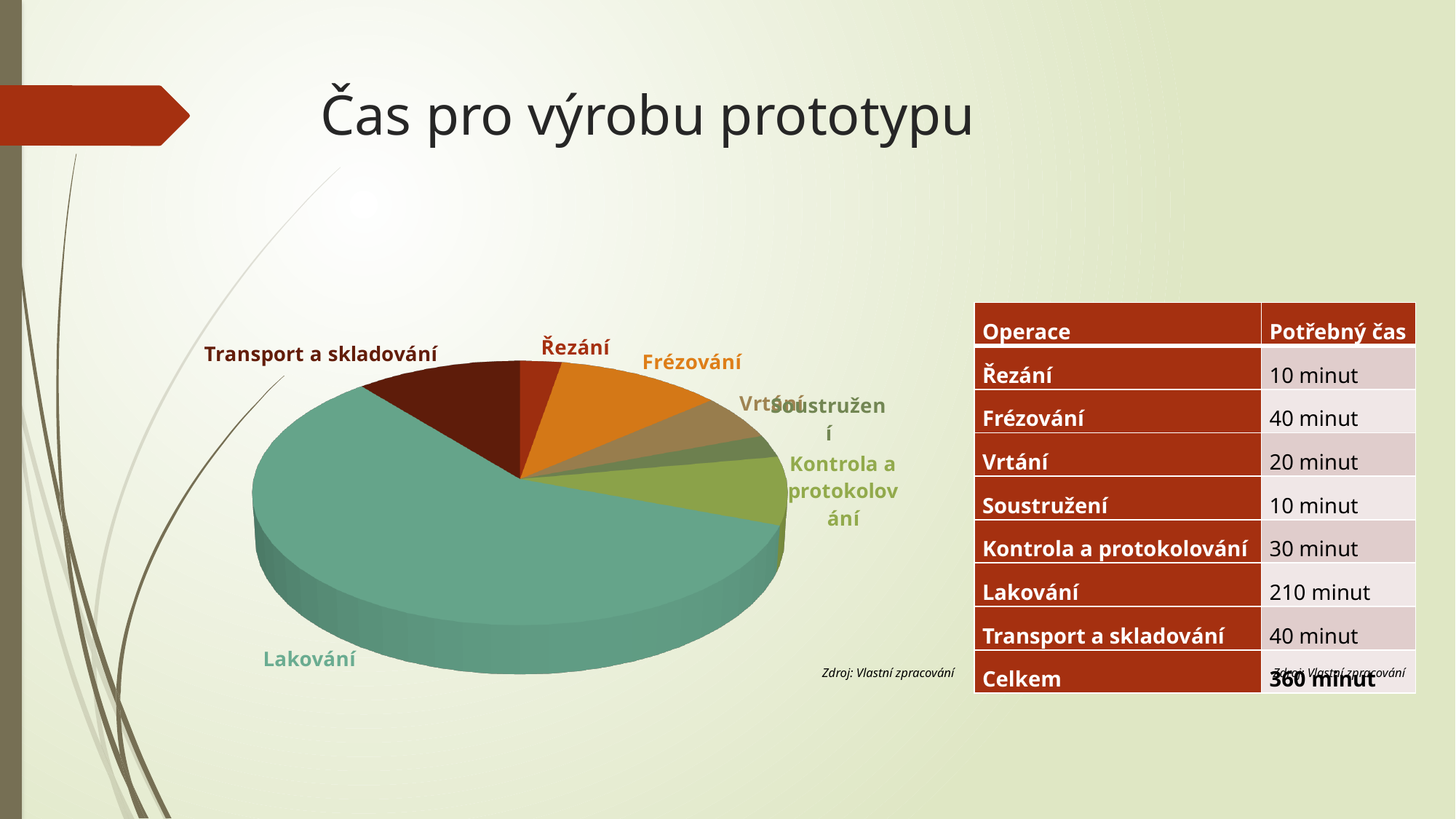
What is the total time for all operations shown on the slide? 360 minut How much time is needed for Kontrola a protokolování according to the slide? 30 minut What source is cited below the pie chart? Zdroj: Vlastní zpracování What kind of chart is shown on the slide? pie chart How much time is needed for Frézování according to the slide? 40 minut How much time is needed for Lakování according to the slide? 210 minut What is the difference in time between Lakování and Frézování? 170 minut Which is larger, the slice for Lakování or the slice for Transport a skladování? Lakování How many slices does the pie chart have? 7 Which operation takes up the largest slice of the pie chart? Lakování How much time is needed for Vrtání according to the slide? 20 minut What is the title of the slide containing the pie chart? Čas pro výrobu prototypu